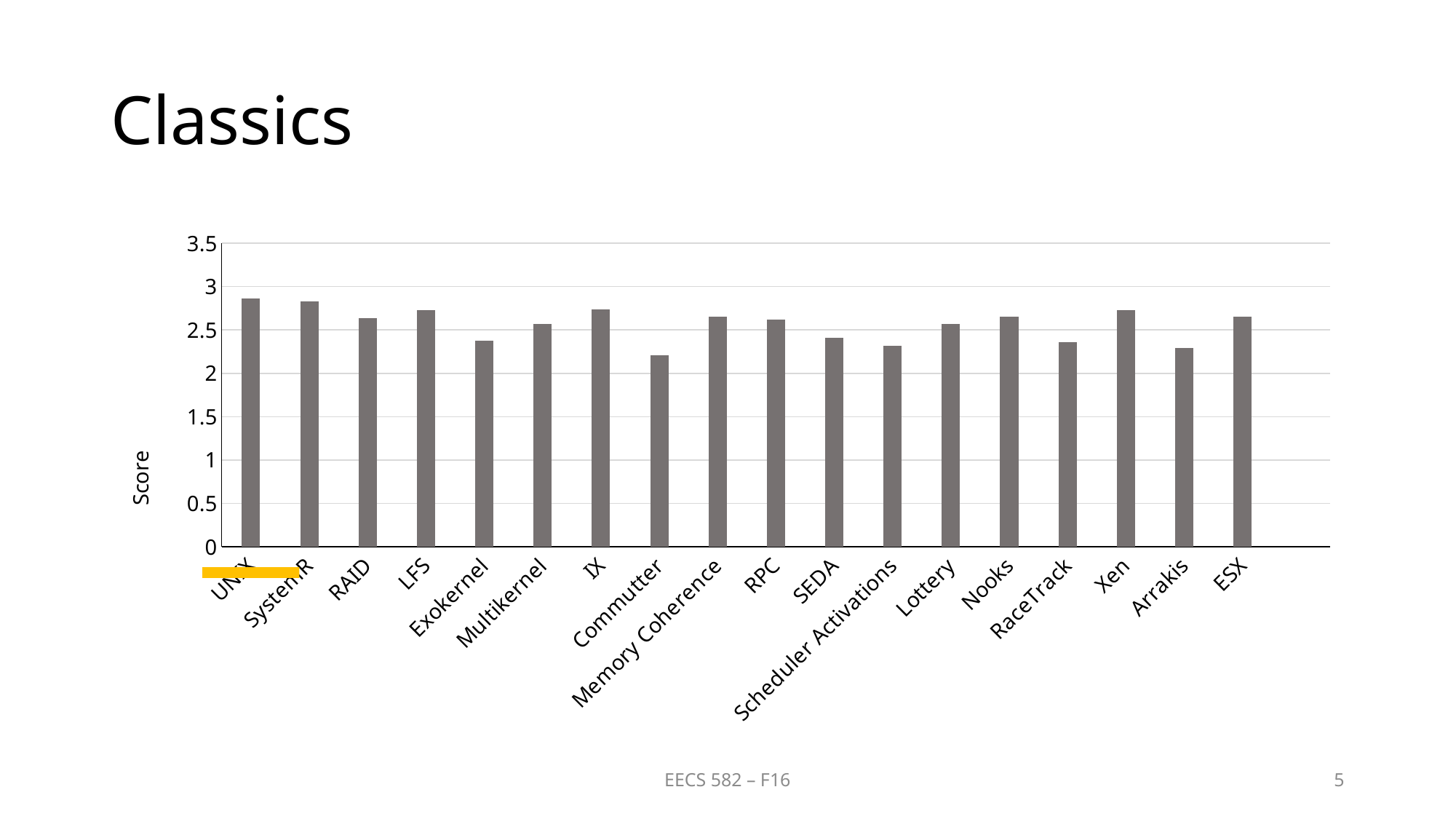
What kind of chart is shown on the slide? bar chart Which has a higher score, LFS or Exokernel? LFS What is the label on the vertical axis of the chart? Score How many categories (bars) are shown in the chart? 18 Which has a higher score, UNIX or Commutter? UNIX Is the value for Arrakis greater or less than 2? greater Which has a higher score, Xen or Arrakis? Xen Which category has the lowest score in the chart? Commutter What is the title of the slide containing the chart? Classics Is the value for Commutter greater or less than 2.5? less Is the value for UNIX greater or less than 2.5? greater